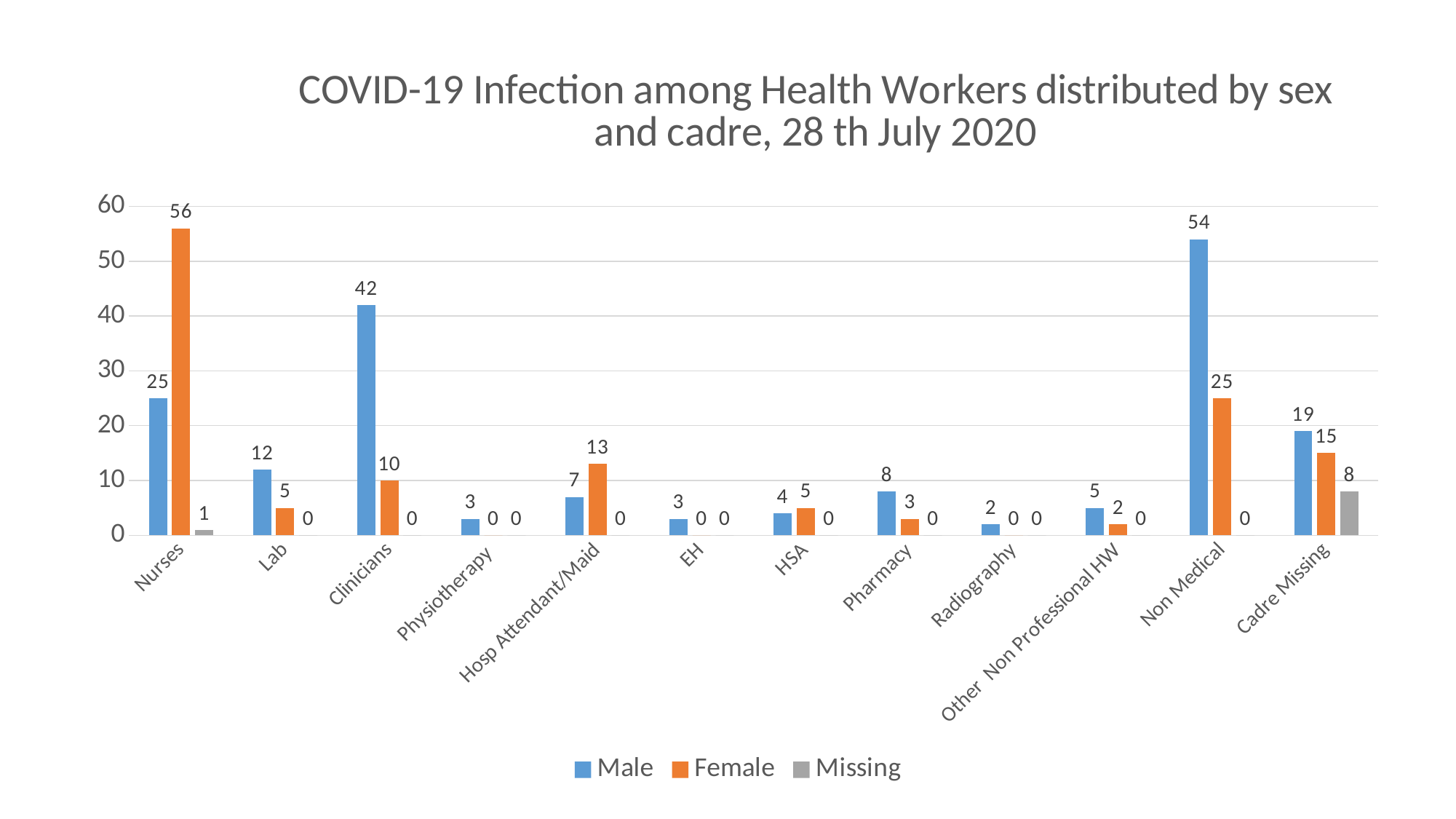
Which category has the highest Male value? Non Medical How many series does the legend list? 3 Which category has the highest Female value? Nurses Which is larger for Hosp Attendant/Maid, the Male value or the Female value? Female What colour represents the Female series? Orange What is the Missing value for Cadre Missing? 8 Is the Male value for Clinicians greater or less than 40? greater What kind of chart is shown on the slide? Bar chart What is the Male value for Clinicians? 42 How many categories are shown on the x axis? 12 What is the difference between the Male and Female values for Non Medical? 29 What is the Female value for Nurses? 56